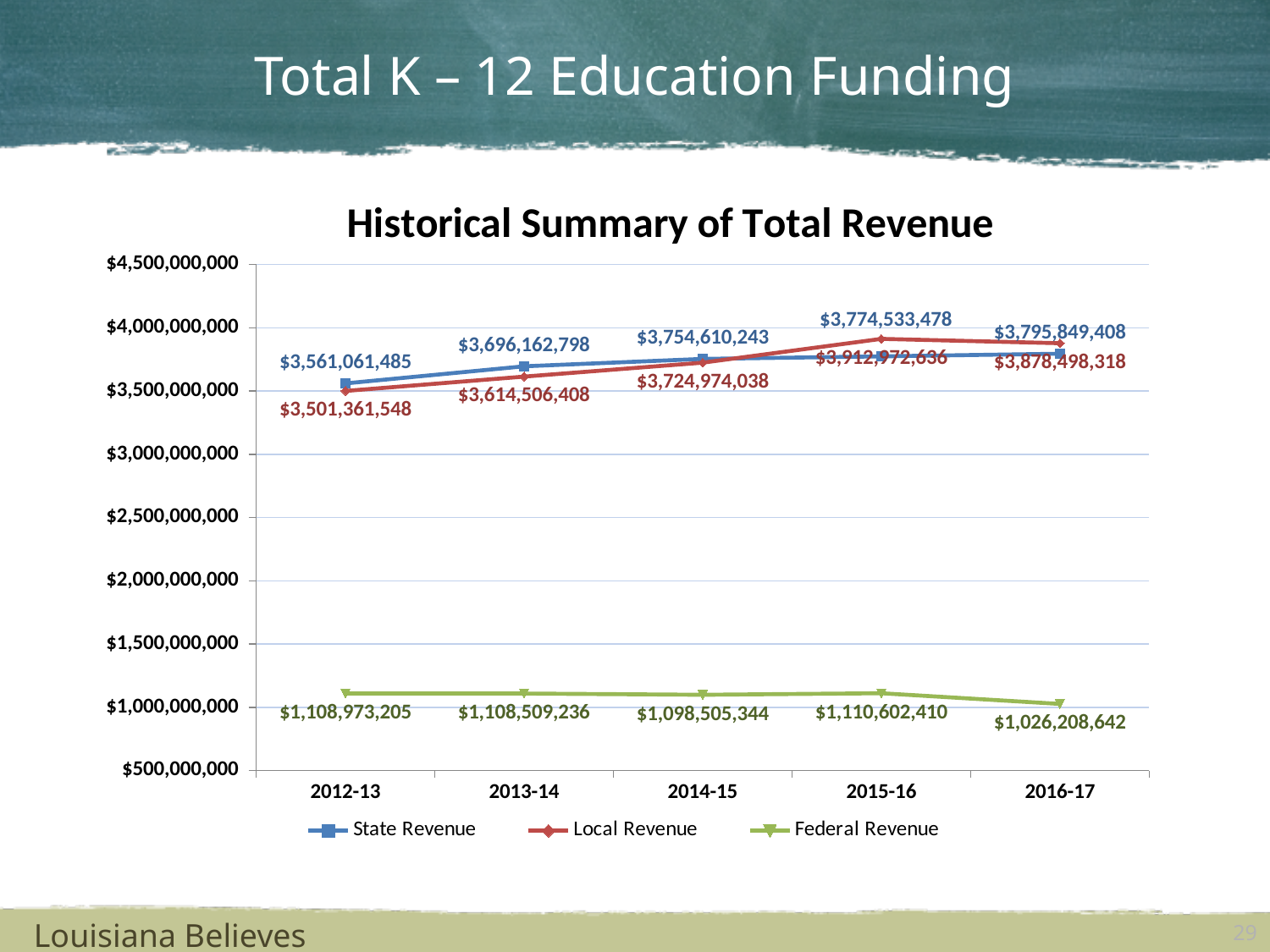
What is the Local Revenue value for 2013-14? $3,614,506,408 What is the difference between State Revenue and Local Revenue in 2012-13? $59,699,937 In 2014-15, which is larger: State Revenue or Local Revenue? State Revenue What is the Federal Revenue value for 2016-17? $1,026,208,642 In which year is Federal Revenue lowest? 2016-17 How many fiscal years are shown on the x axis? 5 Does State Revenue rise or fall from 2012-13 to 2016-17? rises What is the State Revenue value for 2012-13? $3,561,061,485 What kind of chart is shown on the slide? line chart How many series does the legend list? 3 In which year is Federal Revenue highest? 2015-16 Is the Federal Revenue value for 2012-13 greater or less than $1,500,000,000? less